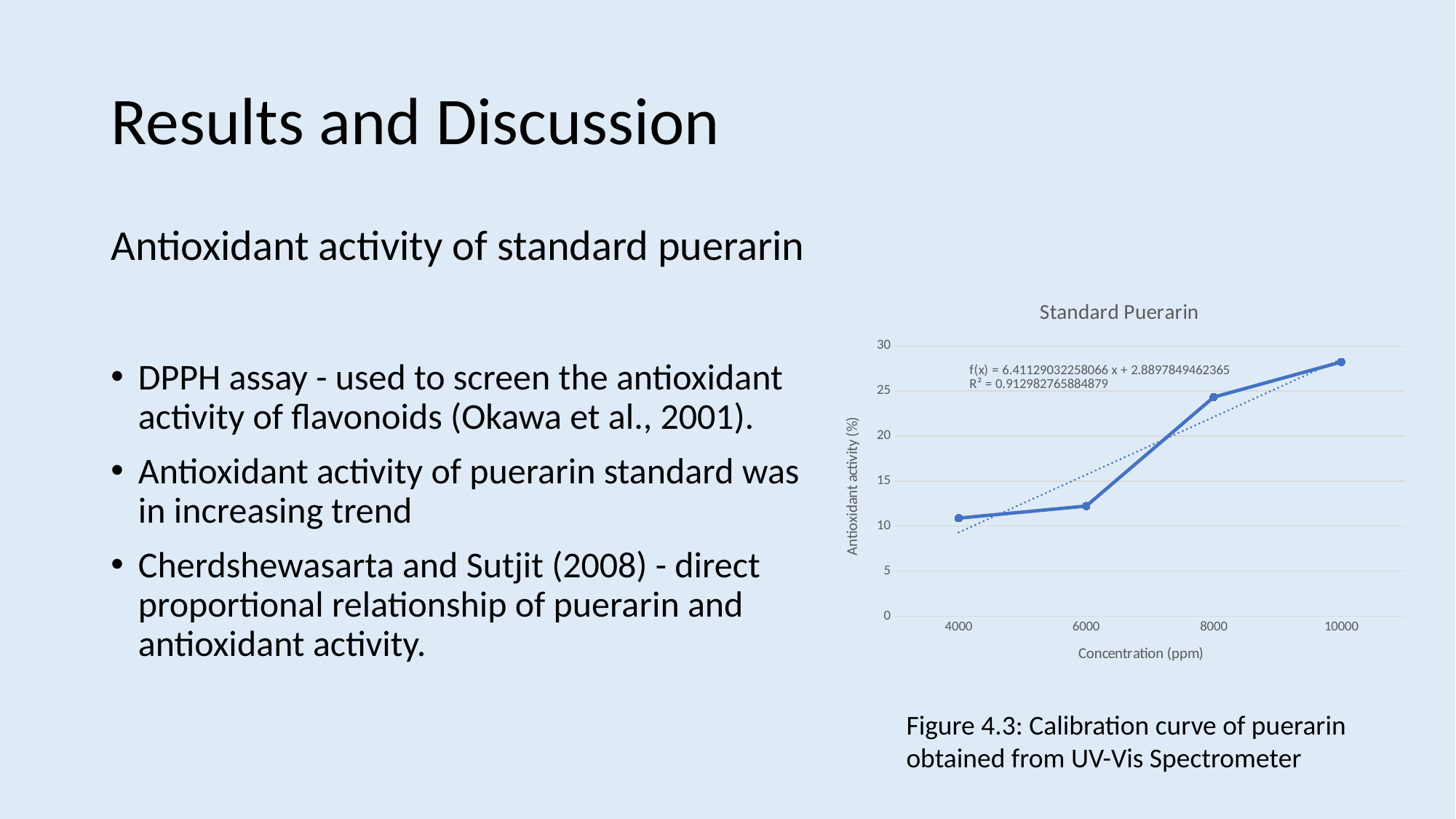
Which concentration has the higher antioxidant activity, 6000 ppm or 8000 ppm? 8000 Is the antioxidant activity at 6000 ppm greater or less than 15? less Does antioxidant activity rise or fall as concentration increases along the x axis? rise At which concentration is the antioxidant activity lowest? 4000 What is the label of the x axis of the chart? Concentration (ppm) At which concentration is the antioxidant activity highest? 10000 Is the antioxidant activity at 10000 ppm greater or less than 25? greater What kind of chart is shown on the slide? line chart Is the antioxidant activity at 8000 ppm greater or less than 20? greater How many data points are plotted on the line in the chart? 4 What is the title of the chart? Standard Puerarin